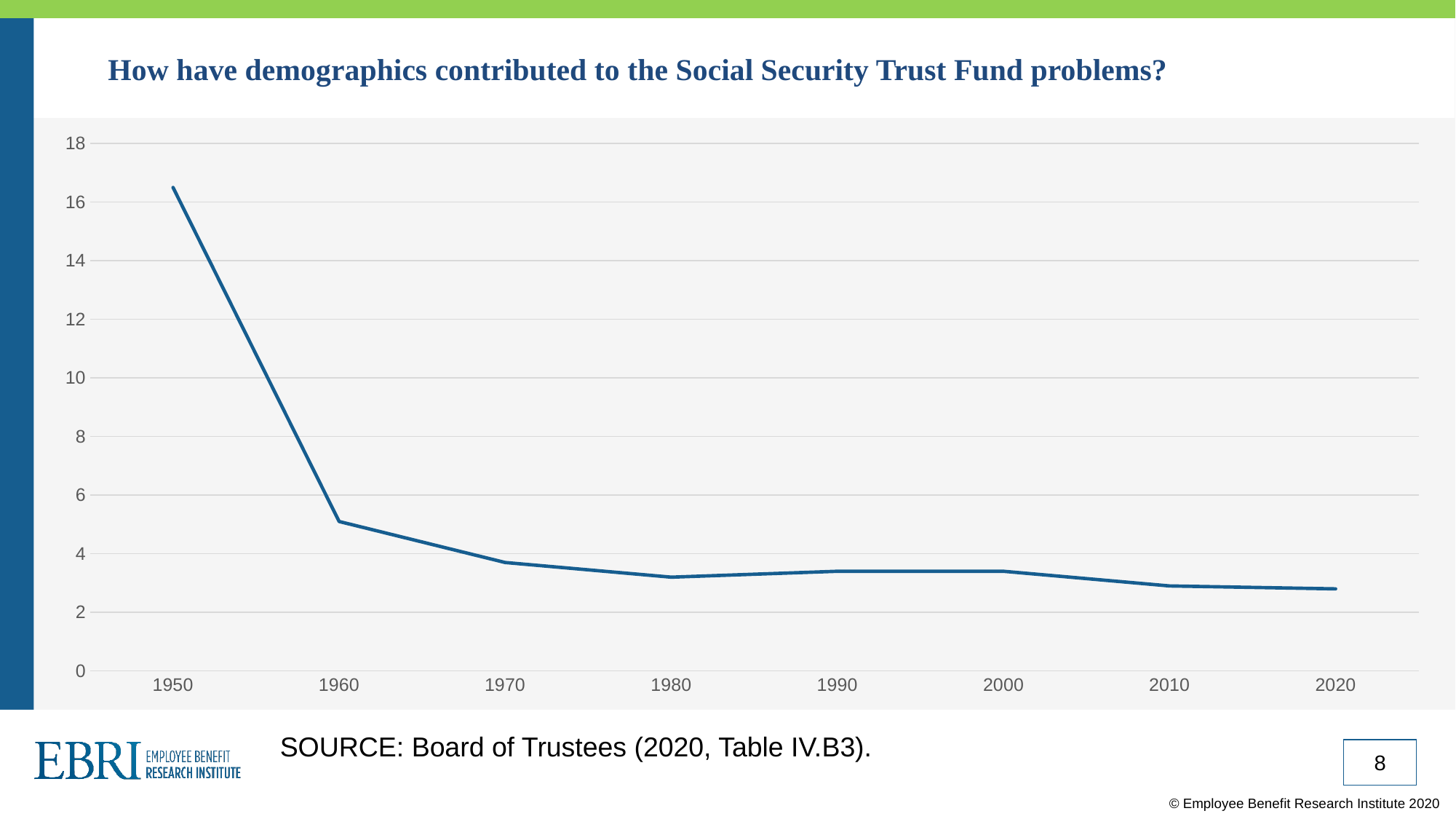
How many years are plotted along the x axis? 8 Is the value for 1960 greater or less than 4? greater Which is larger, the value for 1960 or the value for 2020? 1960 What kind of chart is shown on the slide? line chart Is the value for 1980 greater or less than 4? less Is the value for 1960 greater or less than 6? less Do the values generally rise or fall from 1950 to 2020? fall Which year has the highest value on the line? 1950 Which is larger, the value for 1950 or the value for 1960? 1950 What is the highest tick value shown on the y axis? 18